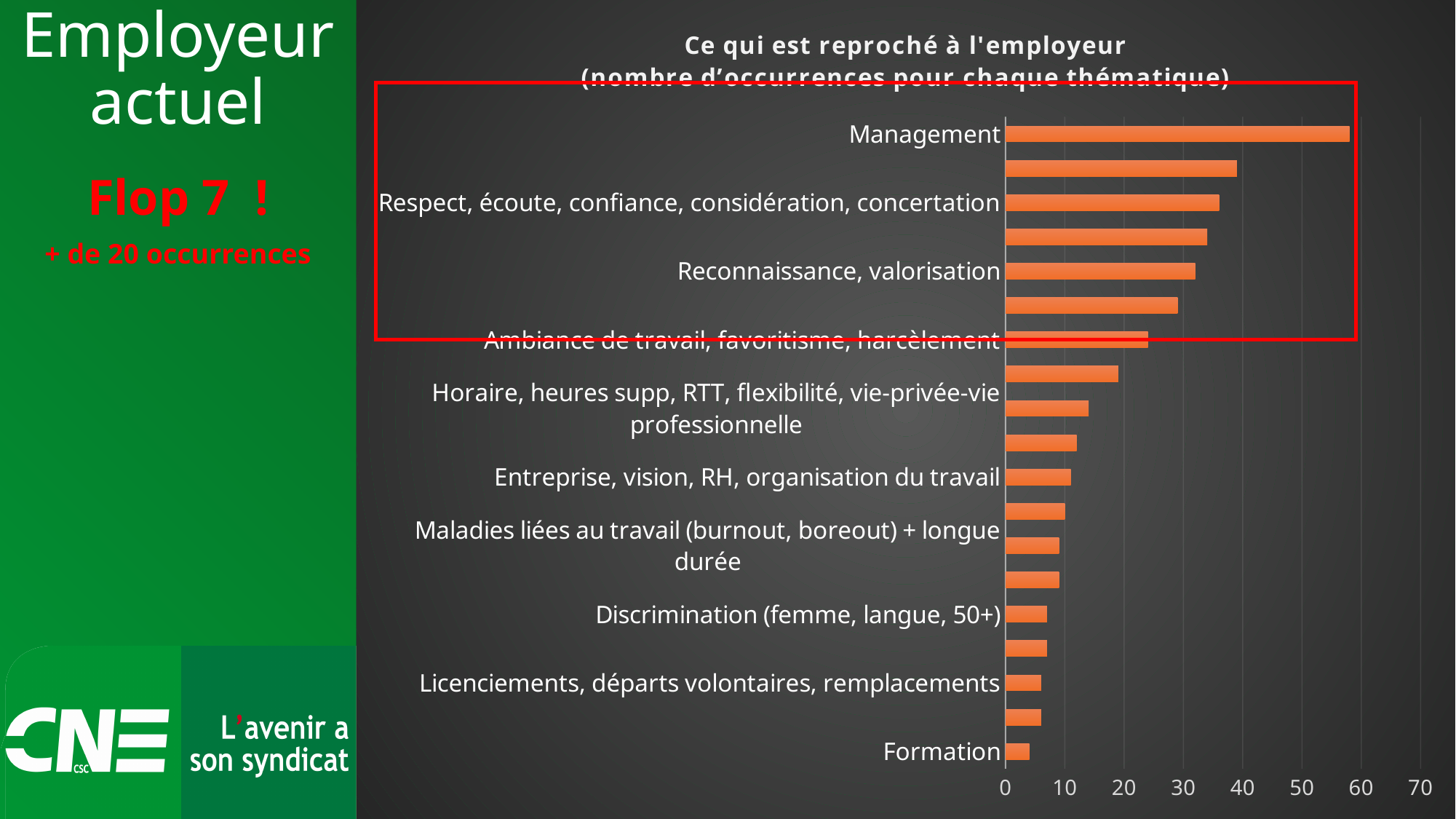
Is the value for 'Discrimination (femme, langue, 50+)' greater or less than 10? less Which has more occurrences, Management or Formation? Management What kind of chart is shown on the slide? bar chart Do the bar values increase or decrease going from the top of the chart to the bottom? decrease Is the value for Management greater or less than 50? greater Is the value for 'Respect, écoute, confiance, considération, concertation' greater or less than 30? greater Which labelled category has the lowest number of occurrences? Formation What is the highest value shown on the horizontal axis? 70 Which category has the highest number of occurrences? Management